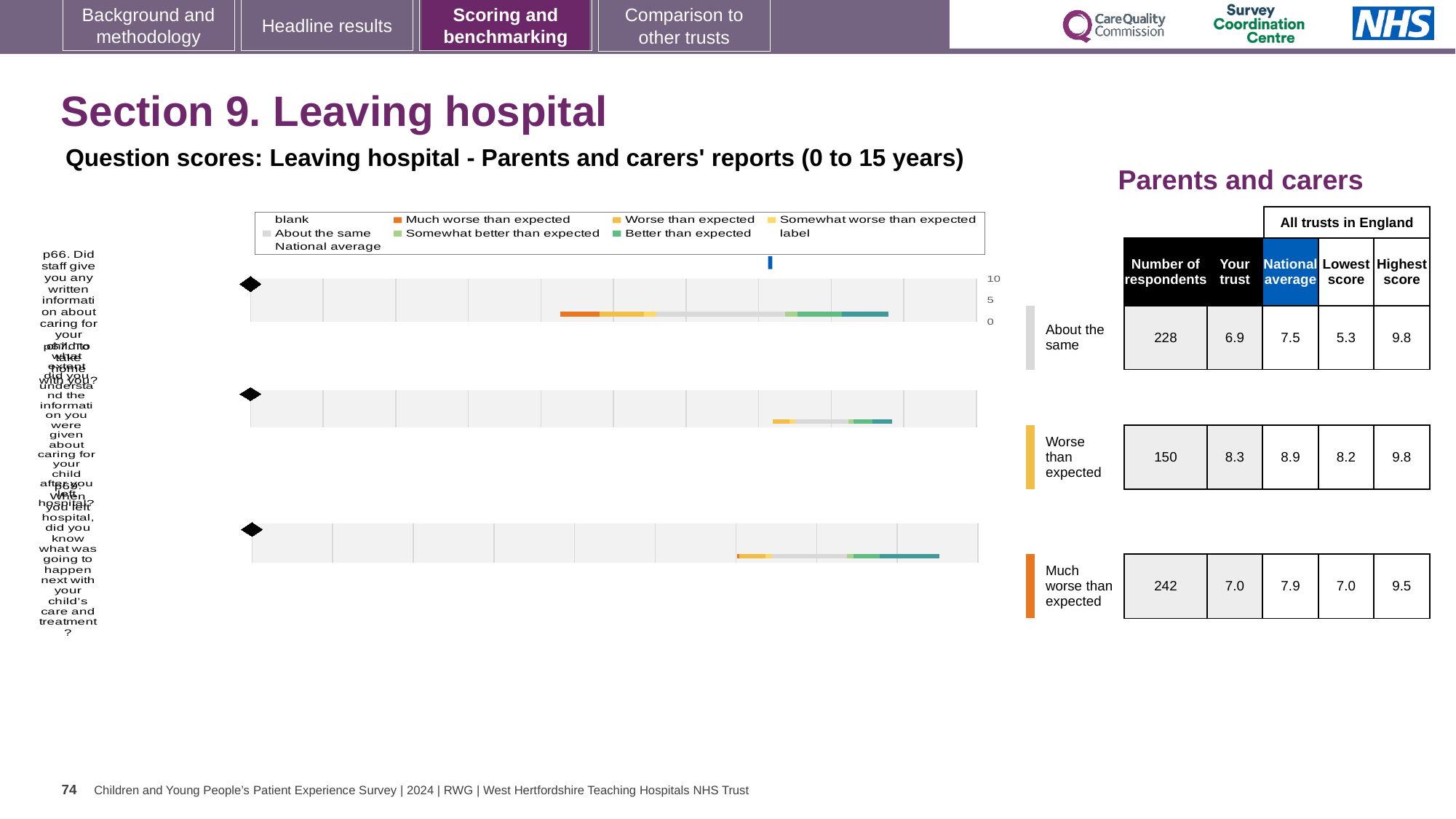
In the Parents and carers table, what is the lowest score for the question rated 'Much worse than expected'? 7.0 Which rating row in the Parents and carers table has the lowest 'Your trust' score? About the same For the question rated 'About the same', which is larger: the 'Your trust' score or the national average? National average In the Parents and carers table, what is the national average for the question rated 'Much worse than expected'? 7.9 In the Parents and carers table, what is the 'Your trust' score for the question rated 'Worse than expected'? 8.3 What is the subtitle above the question score charts? Question scores: Leaving hospital - Parents and carers' reports (0 to 15 years) In the Parents and carers table, what is the number of respondents for the question rated 'About the same'? 228 For the question rated 'Worse than expected', what is the difference between the highest score and the lowest score? 1.6 Which legend entry is shown in orange in the question scores chart legend? Much worse than expected Which rating row in the Parents and carers table has the highest number of respondents? Much worse than expected What kind of chart is used to show the question scores on this slide? bar chart How many question score charts are shown on the slide? 3